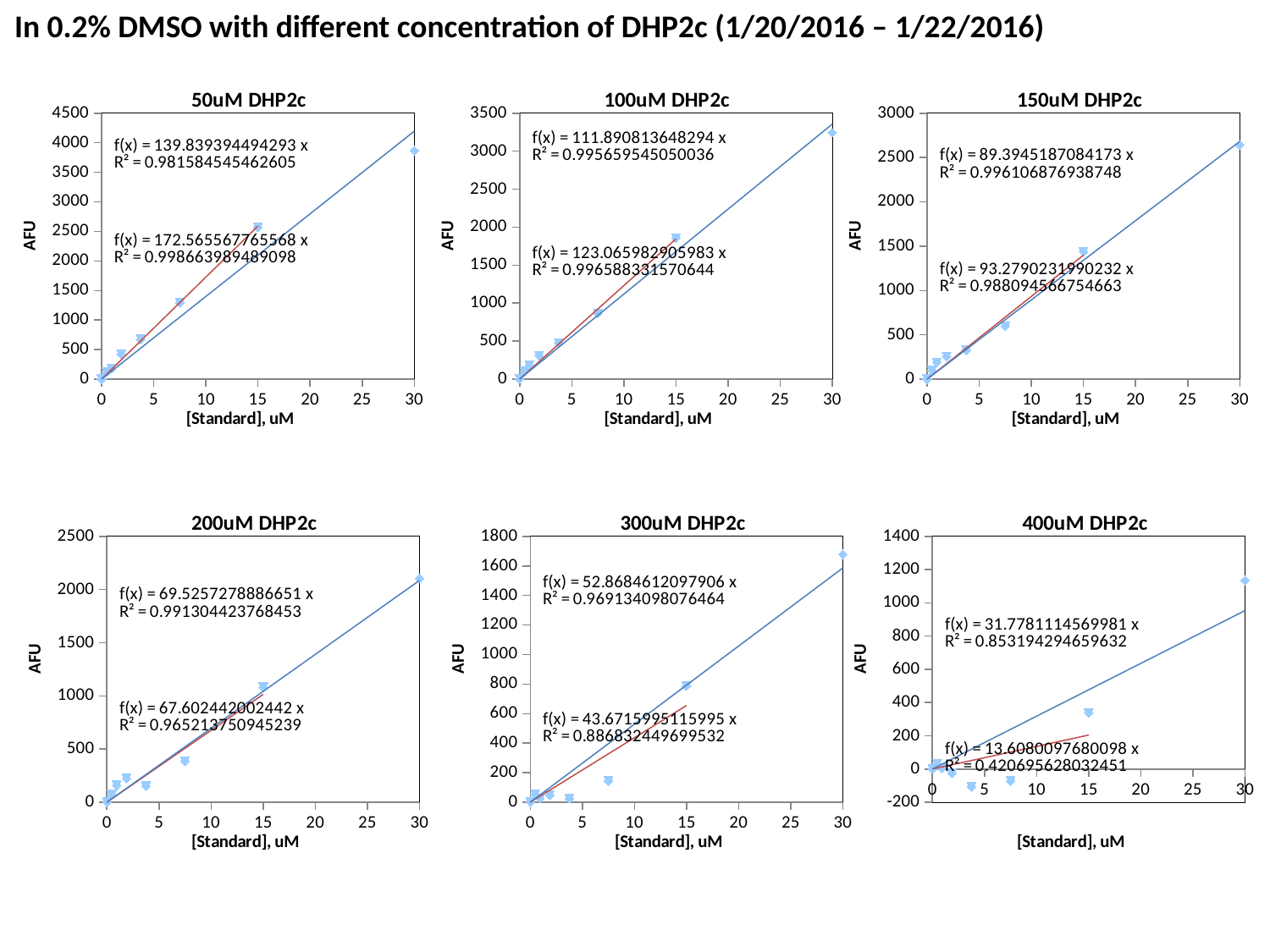
In the 100uM DHP2c chart, which has the larger AFU value: the point at 15 uM or the point at 30 uM? 30 uM In the 400uM DHP2c chart, is the AFU value at 30 uM greater or less than 1000? greater What is the first trendline equation printed on the 50uM DHP2c chart? f(x) = 139.839394494293 x In the 200uM DHP2c chart, do the AFU values rise or fall as the standard concentration increases? rise Which chart has the higher AFU value at 30 uM: the 50uM DHP2c chart or the 400uM DHP2c chart? 50uM DHP2c What is the y-axis label on the 300uM DHP2c chart? AFU What kind of chart is the 50uM DHP2c chart? scatter chart In the 50uM DHP2c chart, is the AFU value at 30 uM greater or less than 3500? greater In the 300uM DHP2c chart, is the AFU value at 15 uM greater or less than 1000? less How many charts are shown on the slide? 6